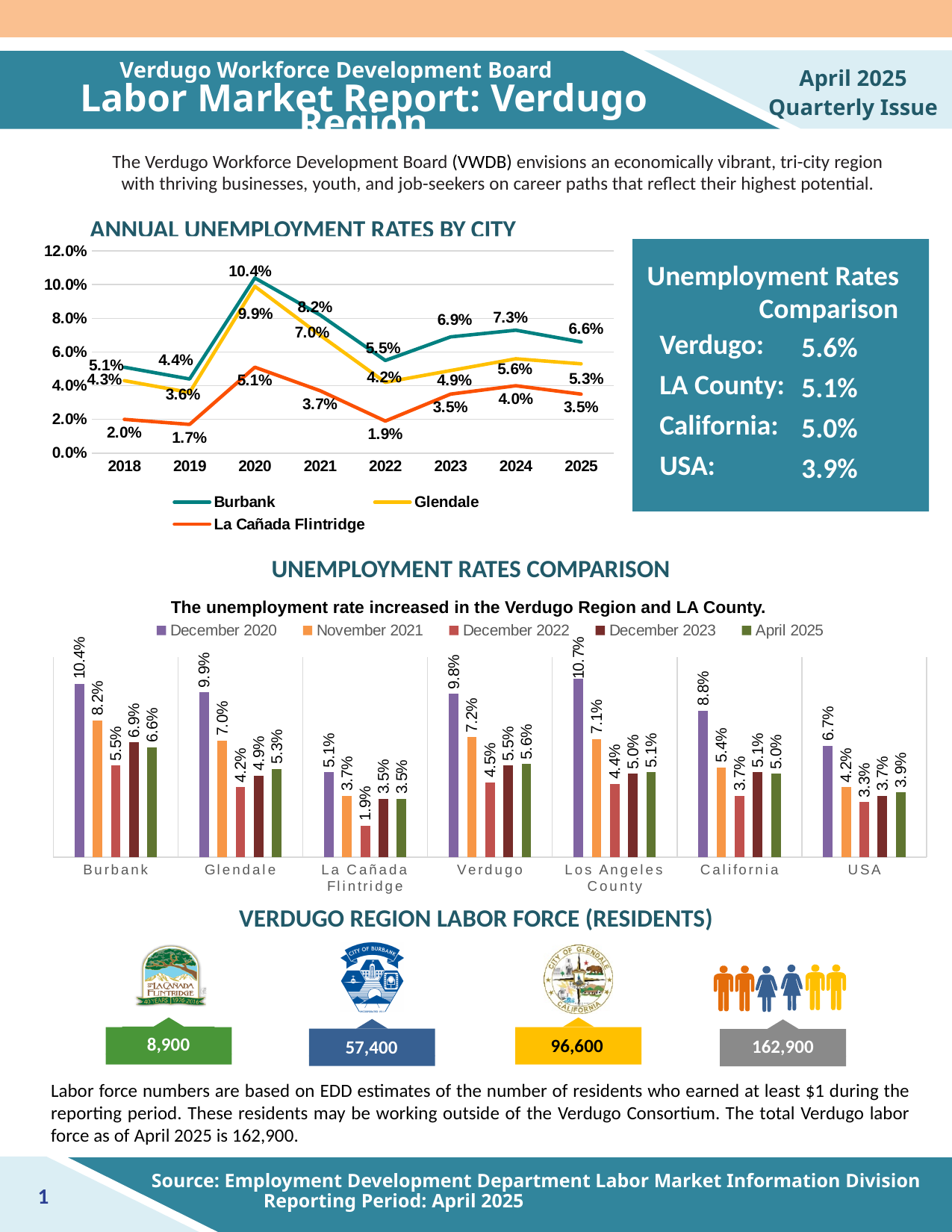
In the 'Annual Unemployment Rates by City' chart, what was La Cañada Flintridge's unemployment rate in 2019? 1.7% In the 'Annual Unemployment Rates by City' chart, what is the difference between Burbank's and Glendale's unemployment rates in 2025? 1.3% In the 'Unemployment Rates Comparison' chart, what was the unemployment rate for Los Angeles County in December 2020? 10.7% In the 'Annual Unemployment Rates by City' chart, how many series does the legend list? 3 In the 'Unemployment Rates Comparison' chart, how many categories are shown on the x axis? 7 In the 'Annual Unemployment Rates by City' chart, did Burbank's unemployment rate rise or fall from 2024 to 2025? Fall In the 'Annual Unemployment Rates by City' chart, which year had the highest unemployment rate for Glendale? 2020 What type of chart is the 'Unemployment Rates Comparison' chart? Bar chart What type of chart is the 'Annual Unemployment Rates by City' chart? Line chart In the 'Annual Unemployment Rates by City' chart, what was Burbank's unemployment rate in 2020? 10.4% In the 'Unemployment Rates Comparison' chart, which category had the lowest unemployment rate in December 2022? La Cañada Flintridge In the 'Unemployment Rates Comparison' chart, which is larger: Verdugo's April 2025 rate or California's April 2025 rate? Verdugo